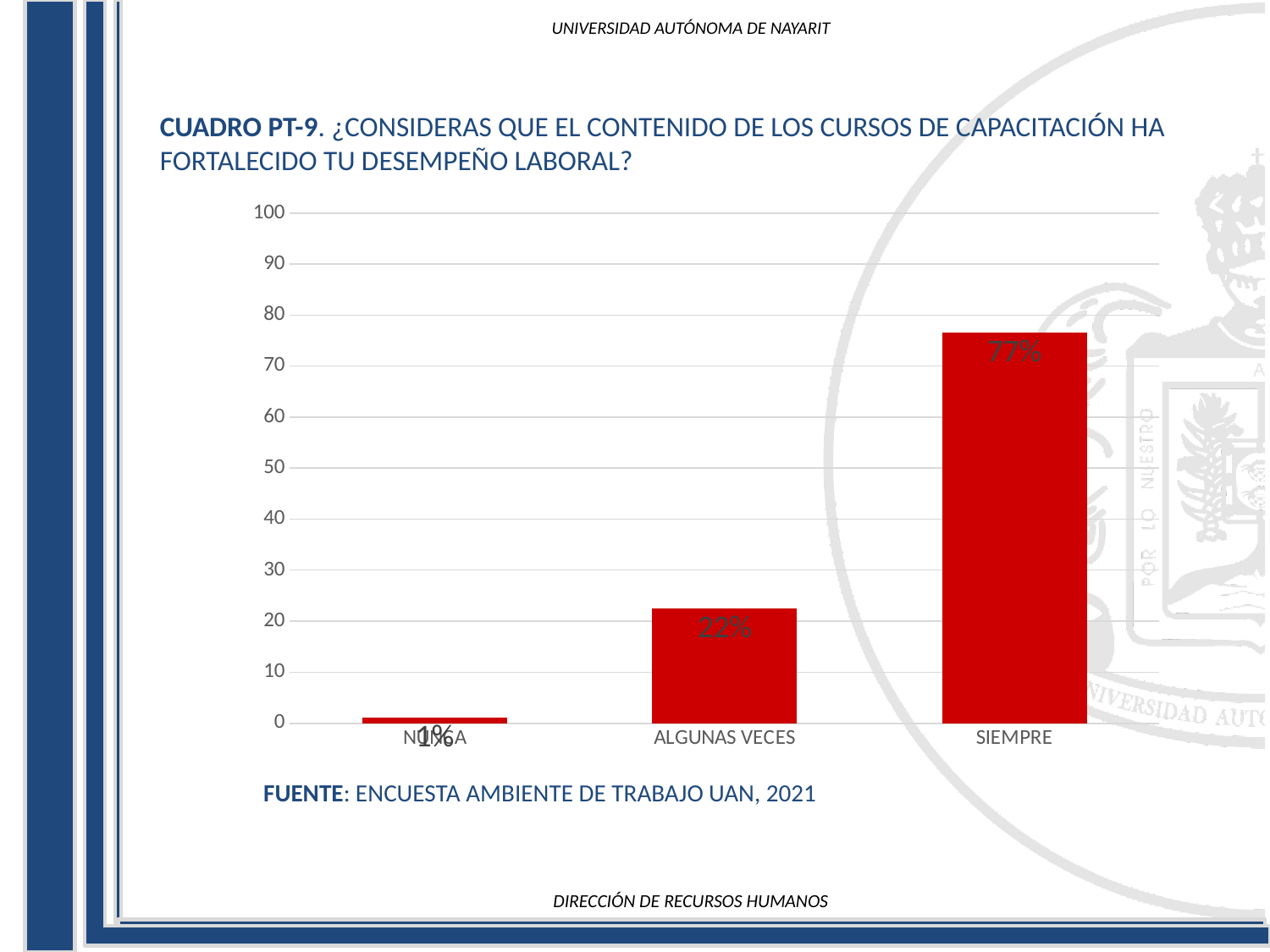
Which category has the lowest value? NUNCA What is the value for SIEMPRE? 77% What is the difference between the values for SIEMPRE and ALGUNAS VECES? 55% Which is larger, the value for ALGUNAS VECES or the value for NUNCA? ALGUNAS VECES What is the value for NUNCA? 1% What is the value for ALGUNAS VECES? 22% What source is cited below the chart? ENCUESTA AMBIENTE DE TRABAJO UAN, 2021 Which category has the highest value? SIEMPRE Is the value for ALGUNAS VECES greater or less than 30? less How many categories are plotted in the chart? 3 What kind of chart is shown on the slide? bar chart Is the value for SIEMPRE greater or less than 70? greater